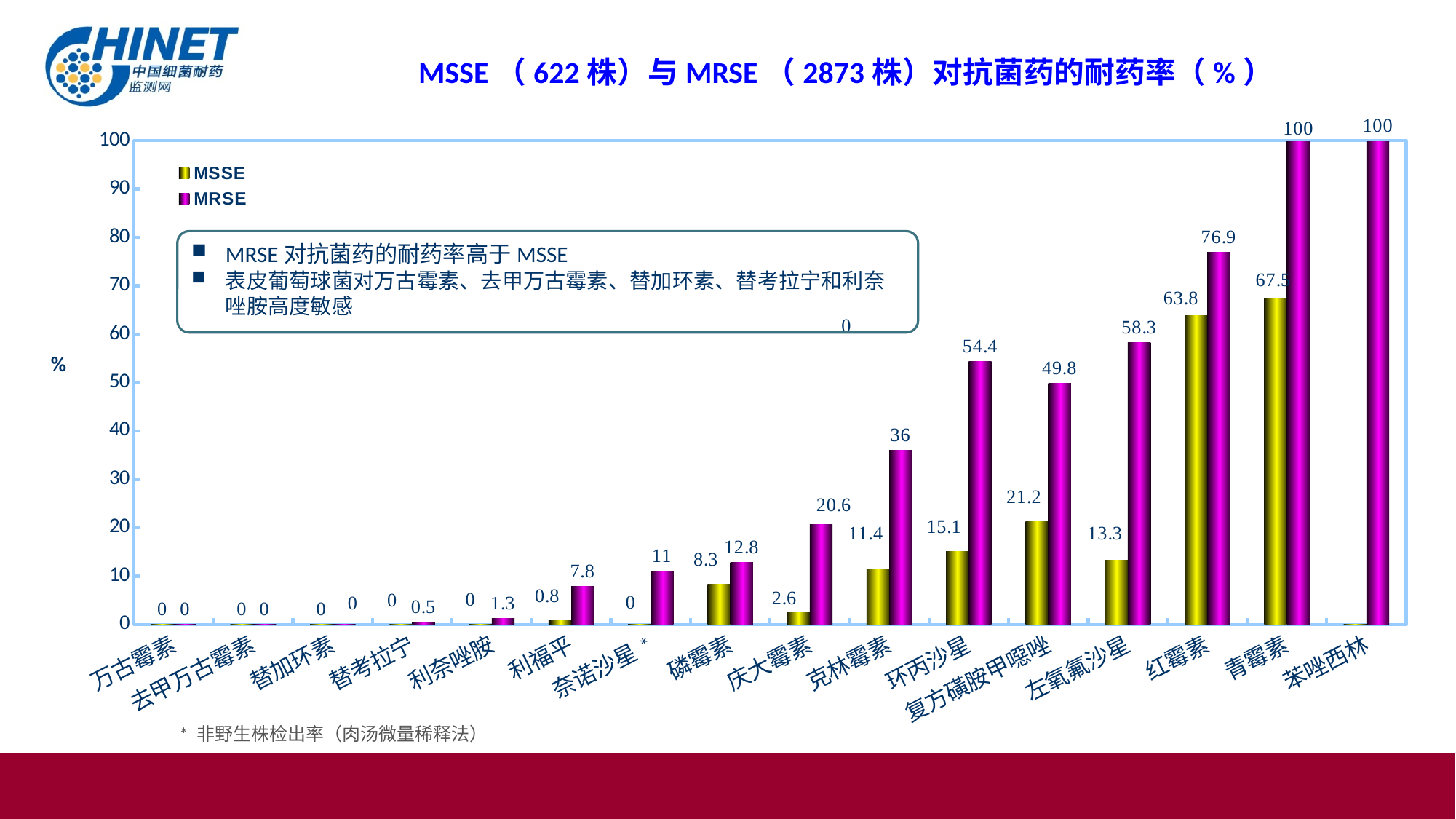
How many antibiotics are shown on the x axis of the chart? 16 What kind of chart is shown on the slide? Bar chart Which has a higher MSSE resistance rate, 环丙沙星 or 左氧氟沙星? 环丙沙星 What is the MSSE resistance rate for 红霉素? 63.8 What is the MSSE resistance rate for 复方磺胺甲噁唑? 21.2 Which antibiotic has the highest MSSE resistance rate? 青霉素 What is the difference between the MRSE and MSSE resistance rates for 克林霉素? 24.6 What is the MRSE resistance rate for 环丙沙星? 54.4 How many series does the legend list? 2 What is the MRSE resistance rate for 庆大霉素? 20.6 Which has a higher MRSE resistance rate, 复方磺胺甲噁唑 or 左氧氟沙星? 左氧氟沙星 What is the difference between the MRSE and MSSE resistance rates for 红霉素? 13.1